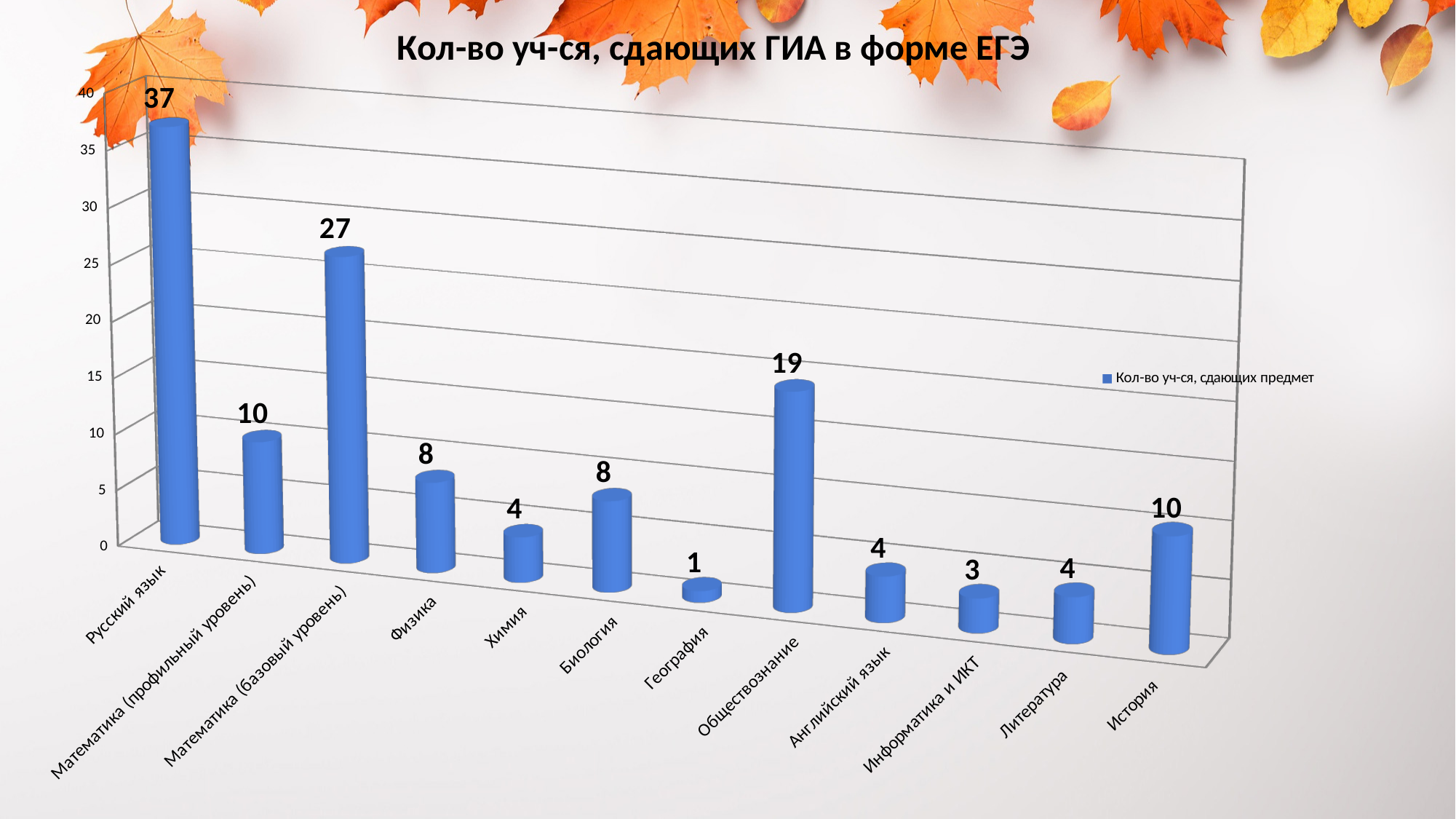
How many categories are shown on the x axis? 12 What is the value for Информатика и ИКТ? 3 What is the value for Русский язык? 37 Which category has the highest value? Русский язык What is the value for Обществознание? 19 How many series does the legend list? 1 What is the difference between the values for Русский язык and Математика (базовый уровень)? 10 What kind of chart is shown? bar chart Which is larger, the value for Обществознание or the value for История? Обществознание Which category has the lowest value? География What is the value for Математика (базовый уровень)? 27 What is the title of the chart? Кол-во уч-ся, сдающих ГИА в форме ЕГЭ